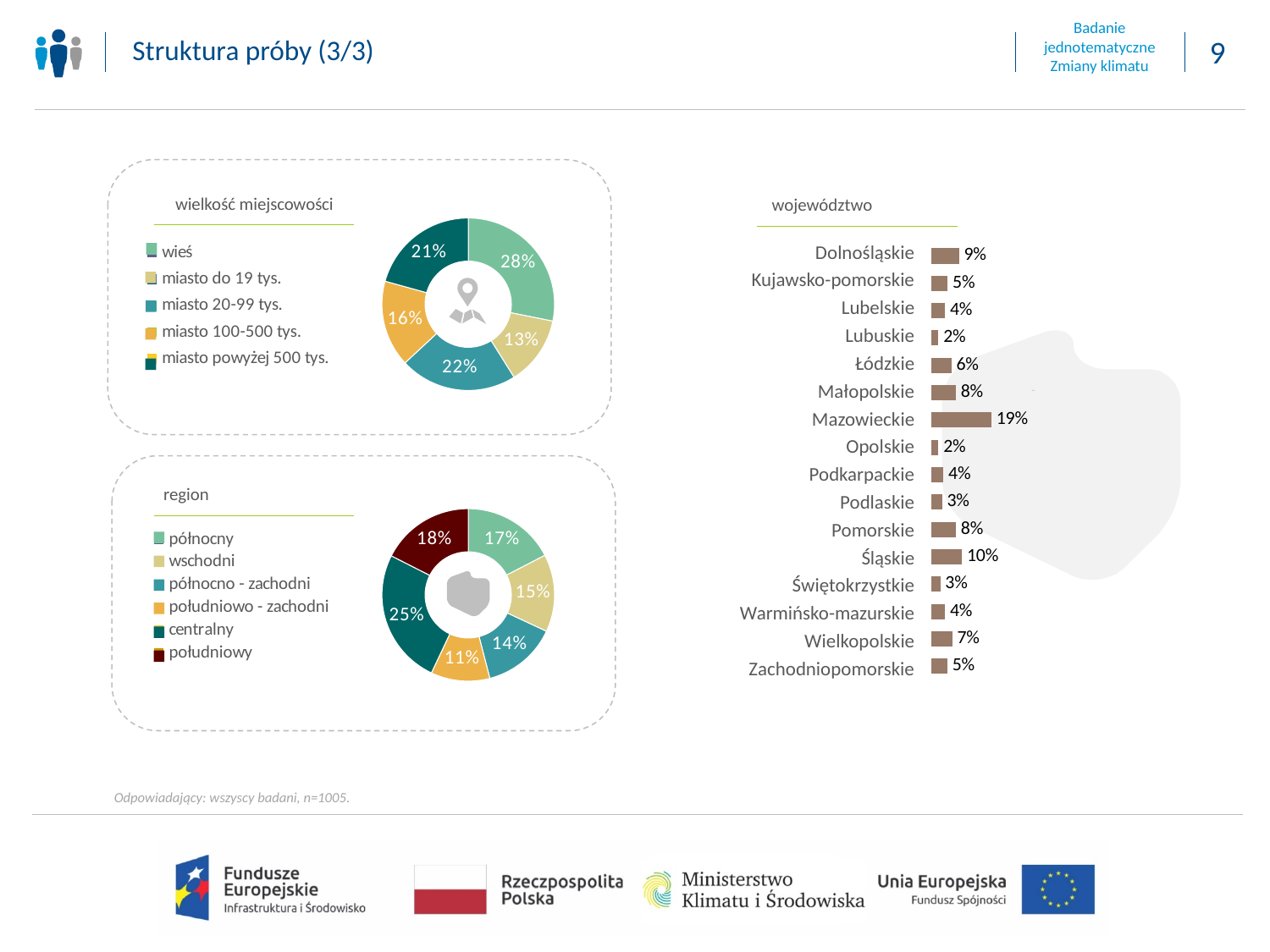
In the 'region' donut chart, which region has the smallest share? południowo - zachodni In the 'wielkość miejscowości' donut chart, what share is 'wieś'? 28% In the 'region' donut chart, what share is 'centralny'? 25% In the 'województwo' bar chart, which is larger: Małopolskie or Wielkopolskie? Małopolskie In the 'województwo' bar chart, which voivodeship has the highest value? Mazowieckie How many categories does the legend of the 'wielkość miejscowości' chart list? 5 In the 'region' donut chart, what is the difference between 'południowy' and 'wschodni'? 3% In the 'wielkość miejscowości' donut chart, which category has the smallest share? miasto do 19 tys. In the 'województwo' bar chart, how many voivodeships are listed? 16 What kind of chart is the 'województwo' chart? bar chart In the 'województwo' bar chart, what is the difference between Śląskie and Dolnośląskie? 1% In the 'województwo' bar chart, what is the value for Mazowieckie? 19%